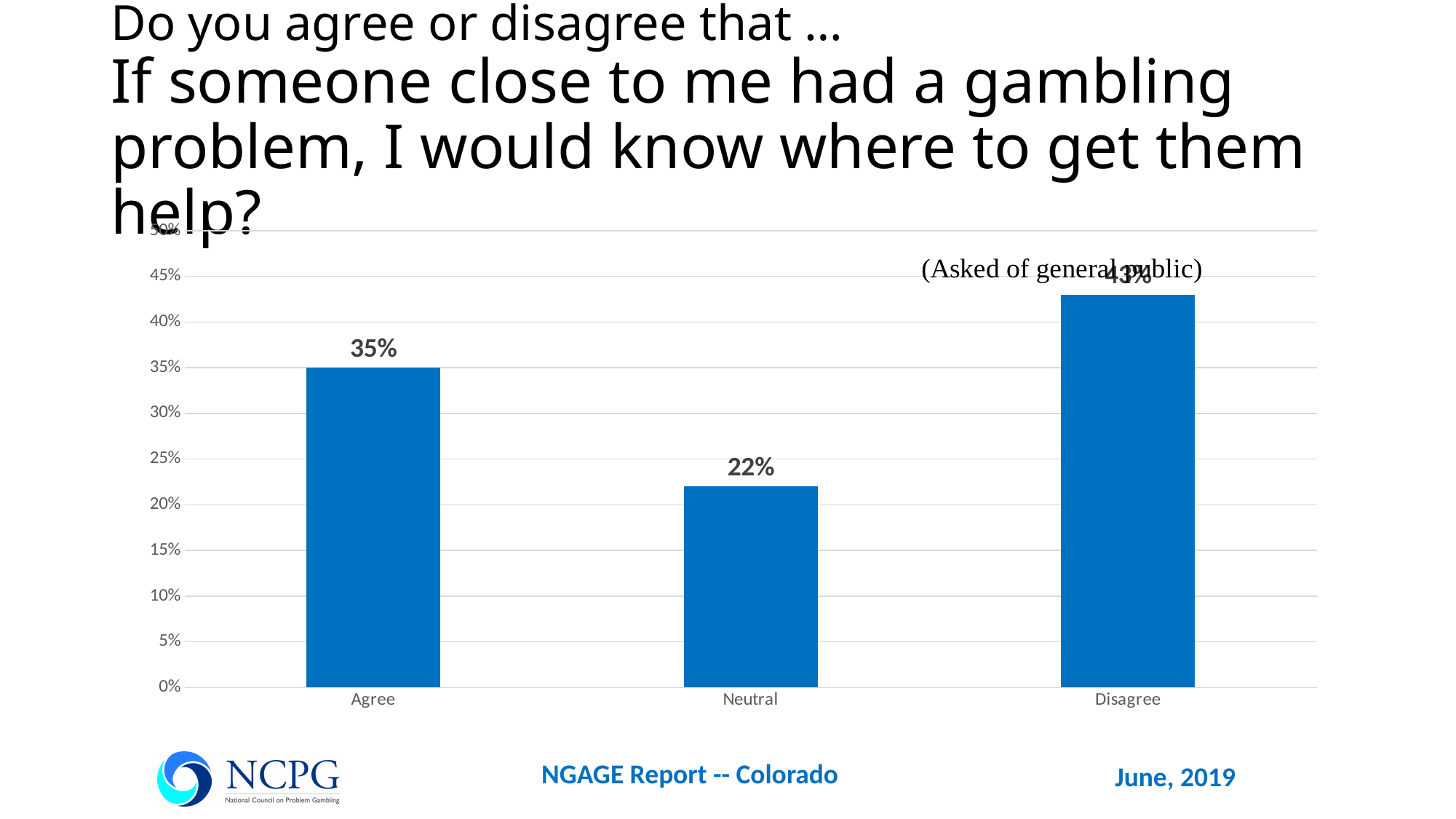
How many response categories are shown on the x axis? 3 According to the note on the chart, who was this question asked of? General public What percentage of respondents chose Neutral? 22% What percentage of respondents chose Disagree? 43% Is the value for Disagree greater or less than 40%? greater What is the difference in percentage points between Agree and Neutral? 13 Which response category has the highest percentage? Disagree Which response category has the lowest percentage? Neutral What percentage of respondents chose Agree? 35% What is the difference in percentage points between Disagree and Agree? 8 Which is larger, the percentage for Agree or the percentage for Neutral? Agree What kind of chart is shown on the slide? Bar chart